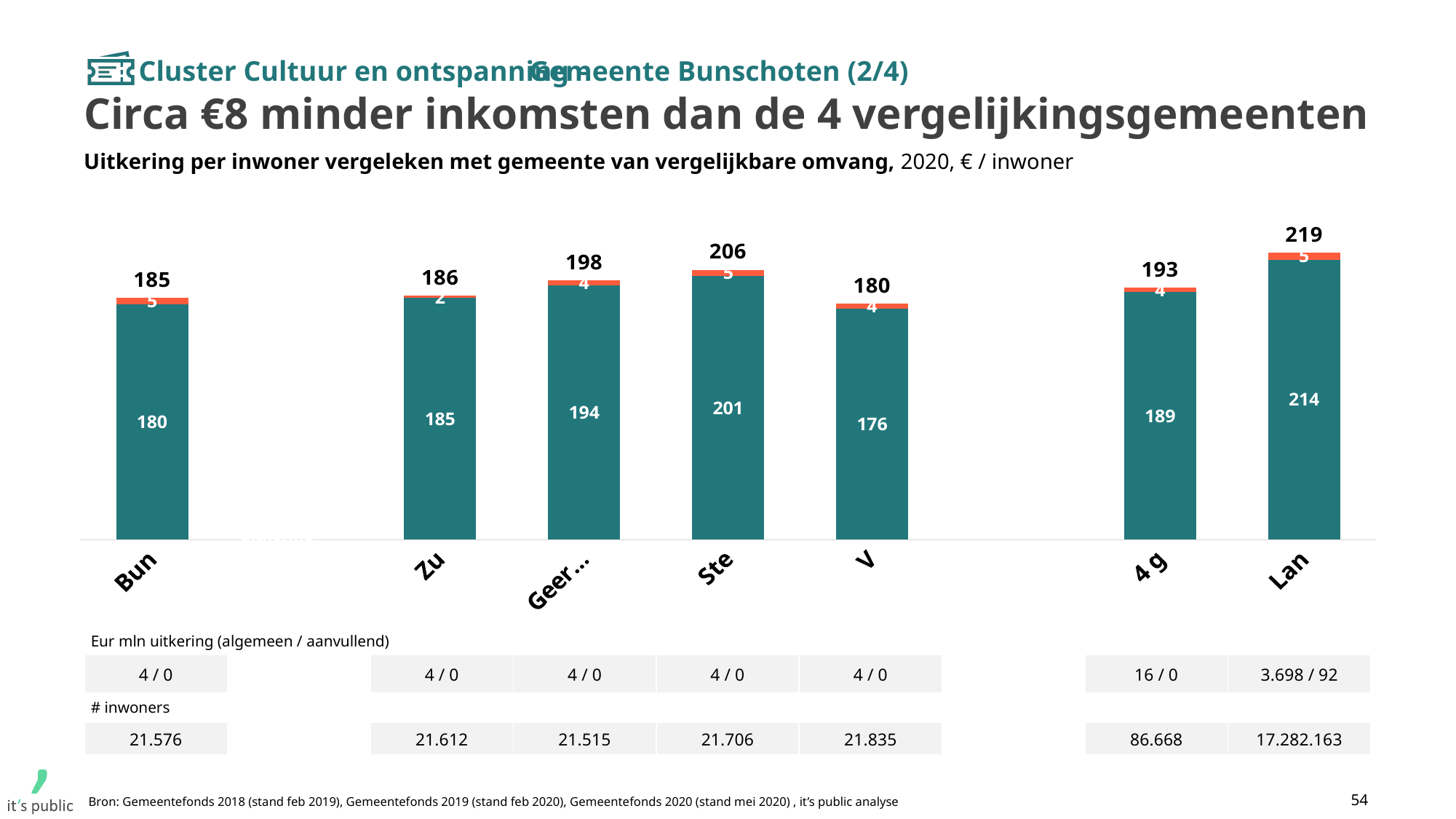
Which category has the highest total value? Lan Which category has the lowest total value? V What is the value of the teal (lower) segment of the bar for Ste? 201 Which has a larger total value, Ste or 4 g? Ste How many bars are plotted in the chart? 7 What is the difference between the total for Lan and the total for Bun? 34 What is the total value shown above the bar for Bun? 185 What is the value of the teal (lower) segment of the bar for V? 176 What is the value of the orange (top) segment of the bar for Zu? 2 What is the total of the stacked bar for 4 g? 193 What unit is stated in the chart subtitle for the values plotted? € / inwoner What kind of chart is shown on the slide? Stacked bar chart